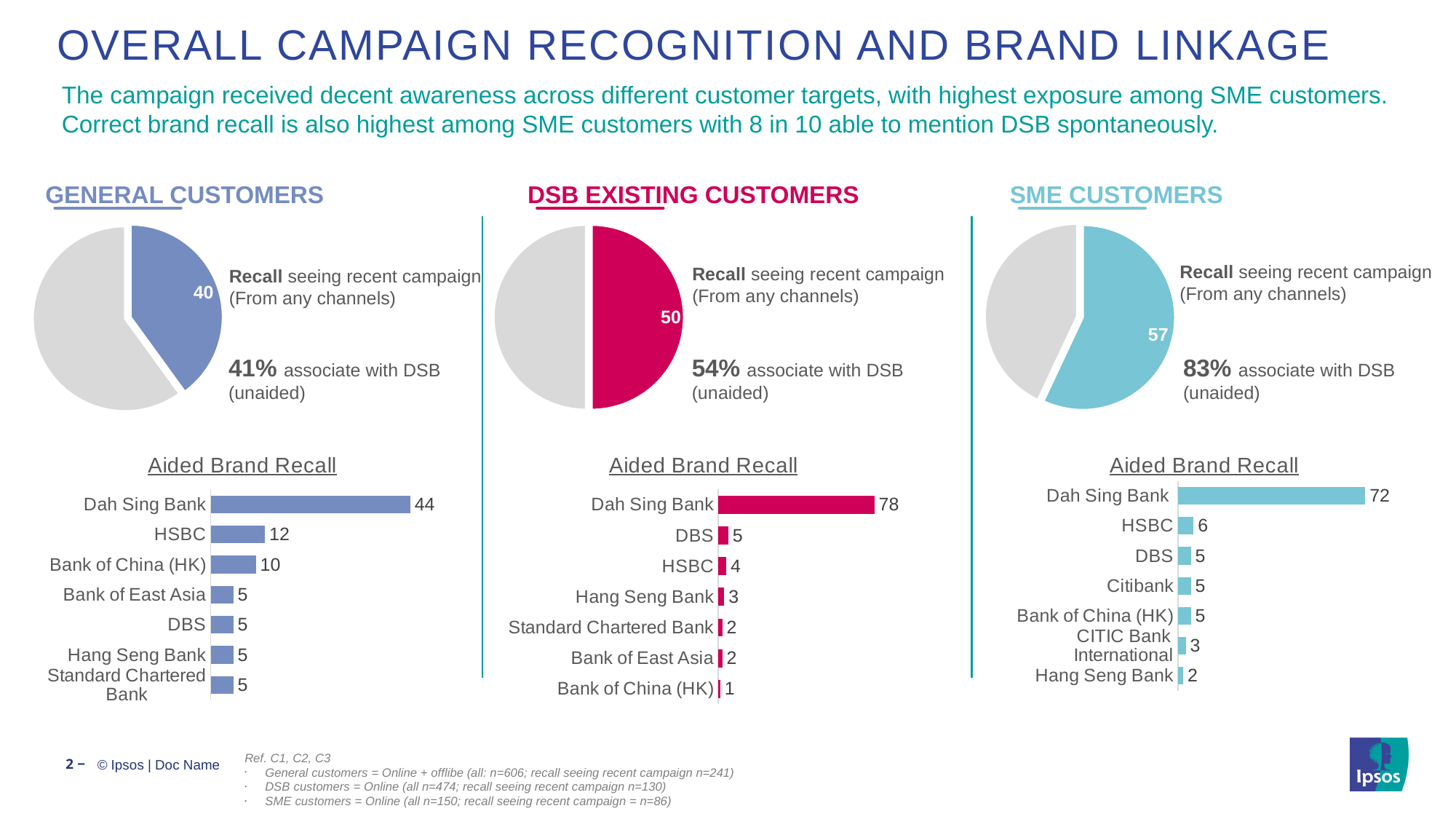
In the General Customers Aided Brand Recall bar chart, what is the value for HSBC? 12 In the SME Customers Aided Brand Recall bar chart, what is the value for CITIC Bank International? 3 In the SME Customers pie chart, what value is shown for recall seeing the recent campaign? 57 In the SME Customers Aided Brand Recall bar chart, what is the difference between Dah Sing Bank and HSBC? 66 In the DSB Existing Customers Aided Brand Recall bar chart, which bank has the lowest value? Bank of China (HK) In the General Customers Aided Brand Recall bar chart, which is larger: HSBC or Bank of China (HK)? HSBC In the DSB Existing Customers pie chart, what value is shown for recall seeing the recent campaign? 50 In the General Customers Aided Brand Recall bar chart, what is the difference between Dah Sing Bank and HSBC? 32 In the DSB Existing Customers Aided Brand Recall bar chart, what is the value for Dah Sing Bank? 78 In the SME Customers Aided Brand Recall bar chart, which bank has the highest value? Dah Sing Bank What type of chart is used for Aided Brand Recall under SME Customers? Bar chart How many banks are listed in the DSB Existing Customers Aided Brand Recall bar chart? 7